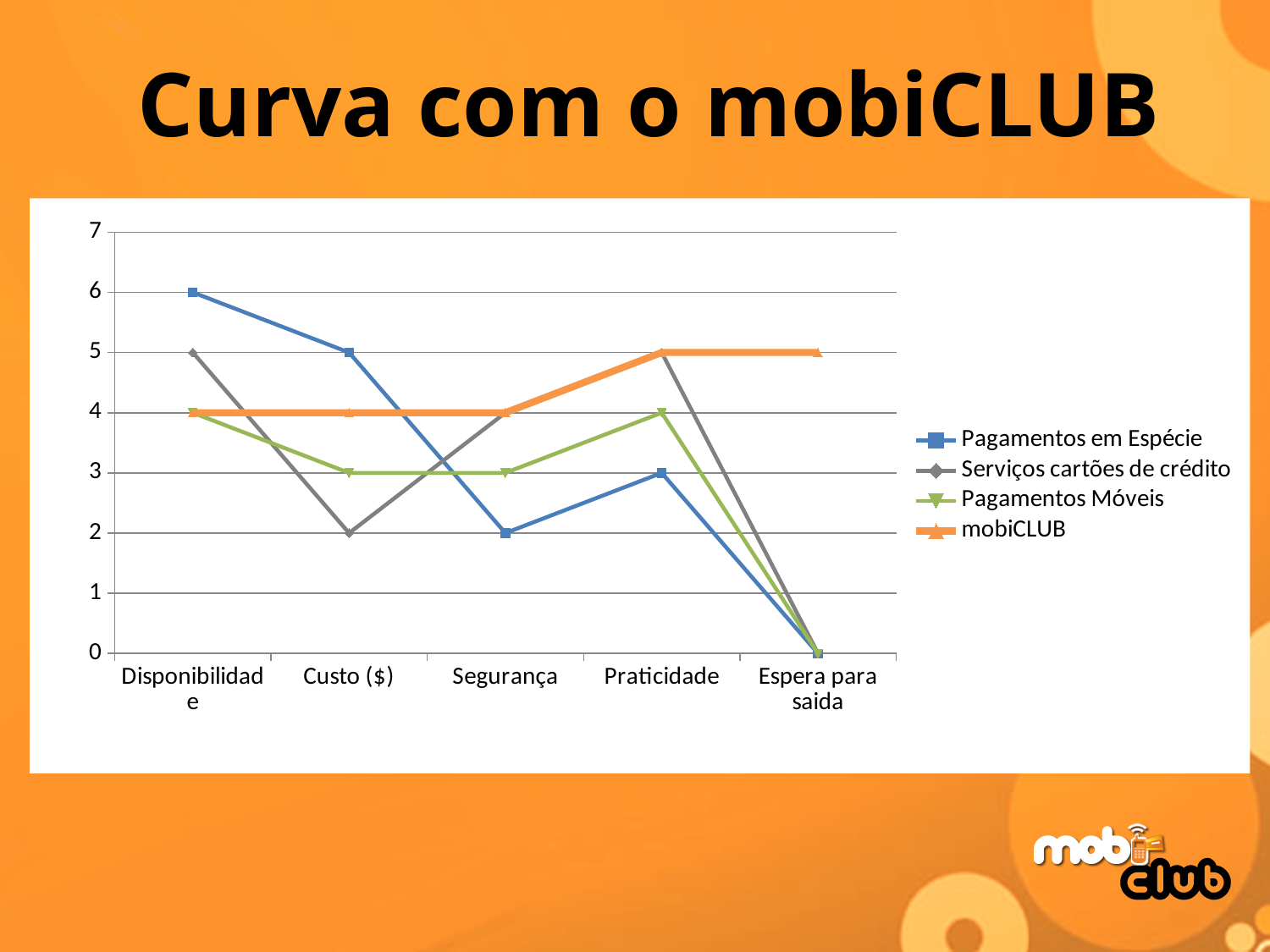
What is the value for Pagamentos Móveis at Praticidade? 4 How many series does the legend list? 4 How many categories are shown on the x axis? 5 What is the difference between Pagamentos em Espécie and Pagamentos Móveis at Segurança? 1 Which category has the lowest value for Serviços cartões de crédito? Espera para saida What is the value for Serviços cartões de crédito at Custo ($)? 2 Does the mobiCLUB series rise or fall from Segurança to Praticidade? rise What is the value for mobiCLUB at Espera para saida? 5 What kind of chart is shown on the slide? line chart Which is larger at Custo ($): Pagamentos em Espécie or Serviços cartões de crédito? Pagamentos em Espécie Which category has the highest value for Pagamentos em Espécie? Disponibilidade What is the value for Pagamentos em Espécie at Disponibilidade? 6